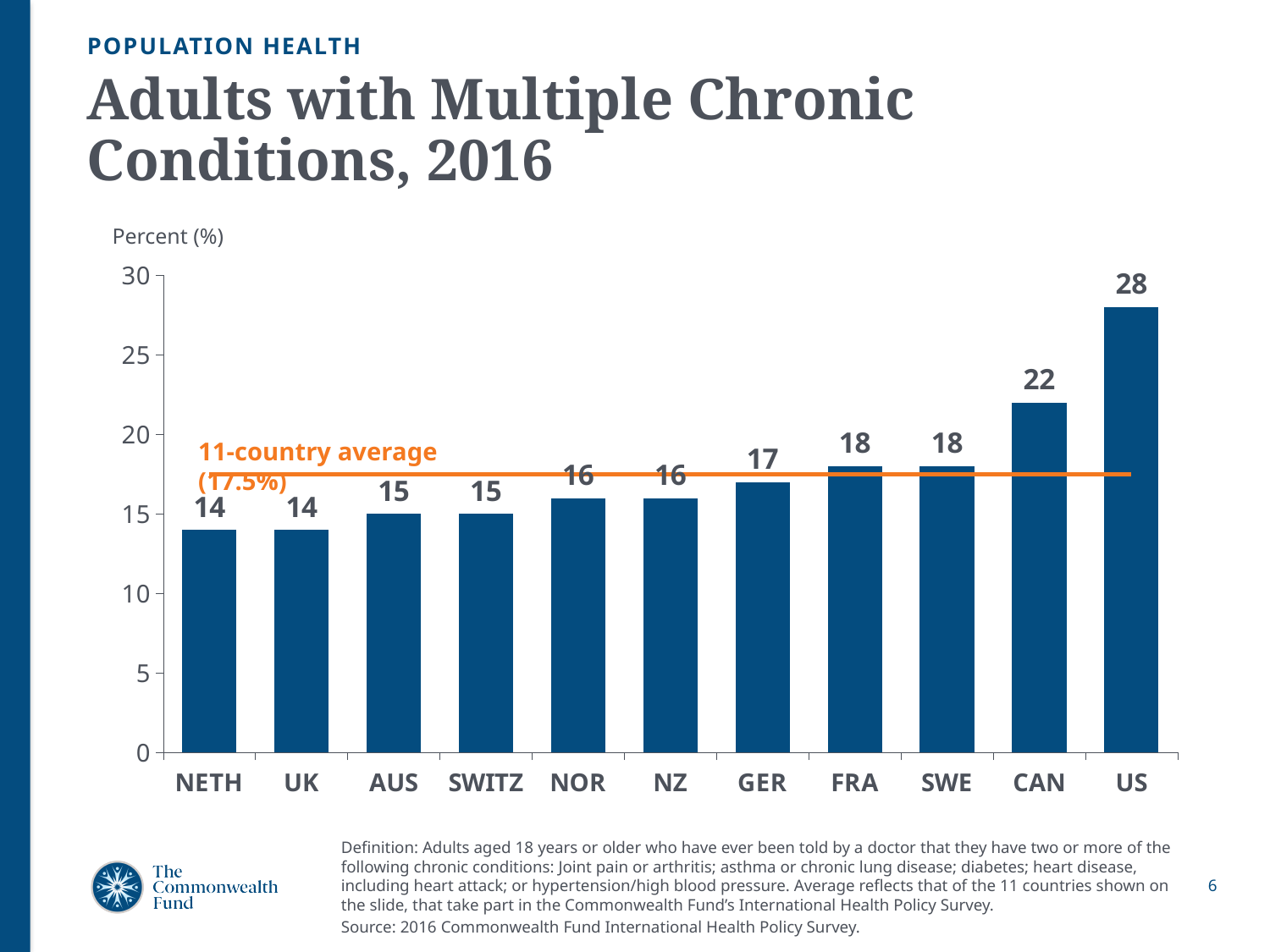
Which is larger, the value for CAN or the value for SWE? CAN What is the value for the US? 28 Which country has the highest value? US How many countries are shown on the chart? 11 Is the value for the US greater or less than 25? greater What is the difference between the values for the US and CAN? 6 What is the difference between the values for FRA and NETH? 4 What is the value for CAN? 22 What kind of chart is shown on the slide? bar chart What is the value for GER? 17 What is the 11-country average shown on the chart? 17.5% Do the values generally rise or fall from left to right across the countries? rise